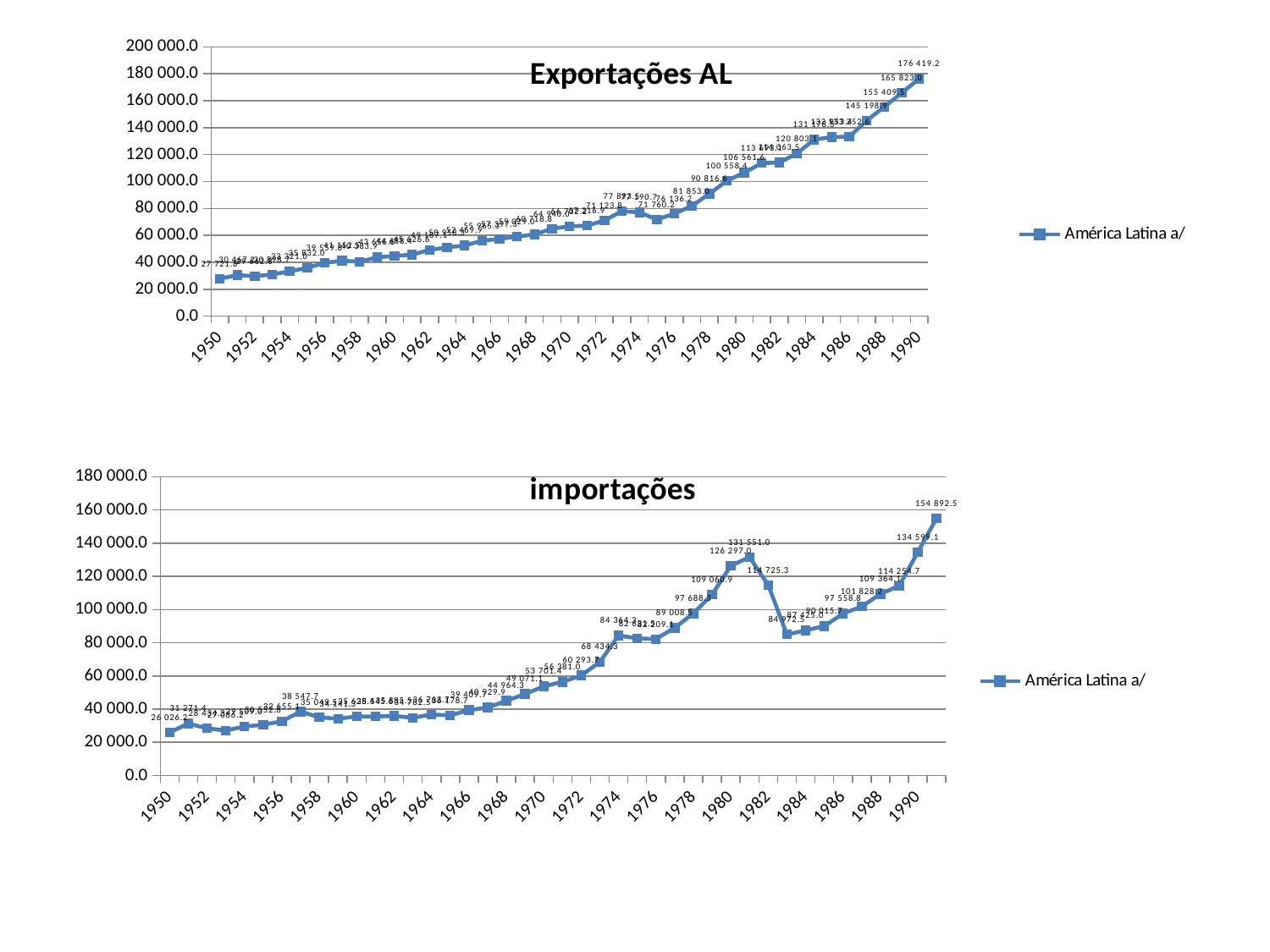
In the 'Exportações AL' chart, what is the highest value plotted? 176 419.2 In the 'importações' chart, what is the value for 1981? 131 551.0 In the 'Exportações AL' chart, what is the difference between the 1990 value (176 419.2) and the 1989 value (165 823.0)? 10 596.2 In the 'importações' chart, what is the value for 1950? 26 026.2 In the 'Exportações AL' chart, do the values generally rise or fall from 1950 to 1990? rise In the 'Exportações AL' chart, is the value for 1970 greater or less than 80 000.0? less In the 'importações' chart, what is the highest value plotted? 154 892.5 In the 'Exportações AL' chart, what is the value for 1950? 27 721.8 How many series does the legend of the 'importações' chart list? 1 In the 'importações' chart, which year has the larger value, 1981 or 1983? 1981 In the 'Exportações AL' chart, what is the value for 1980? 106 561.6 What type of chart is the 'Exportações AL' chart? line chart